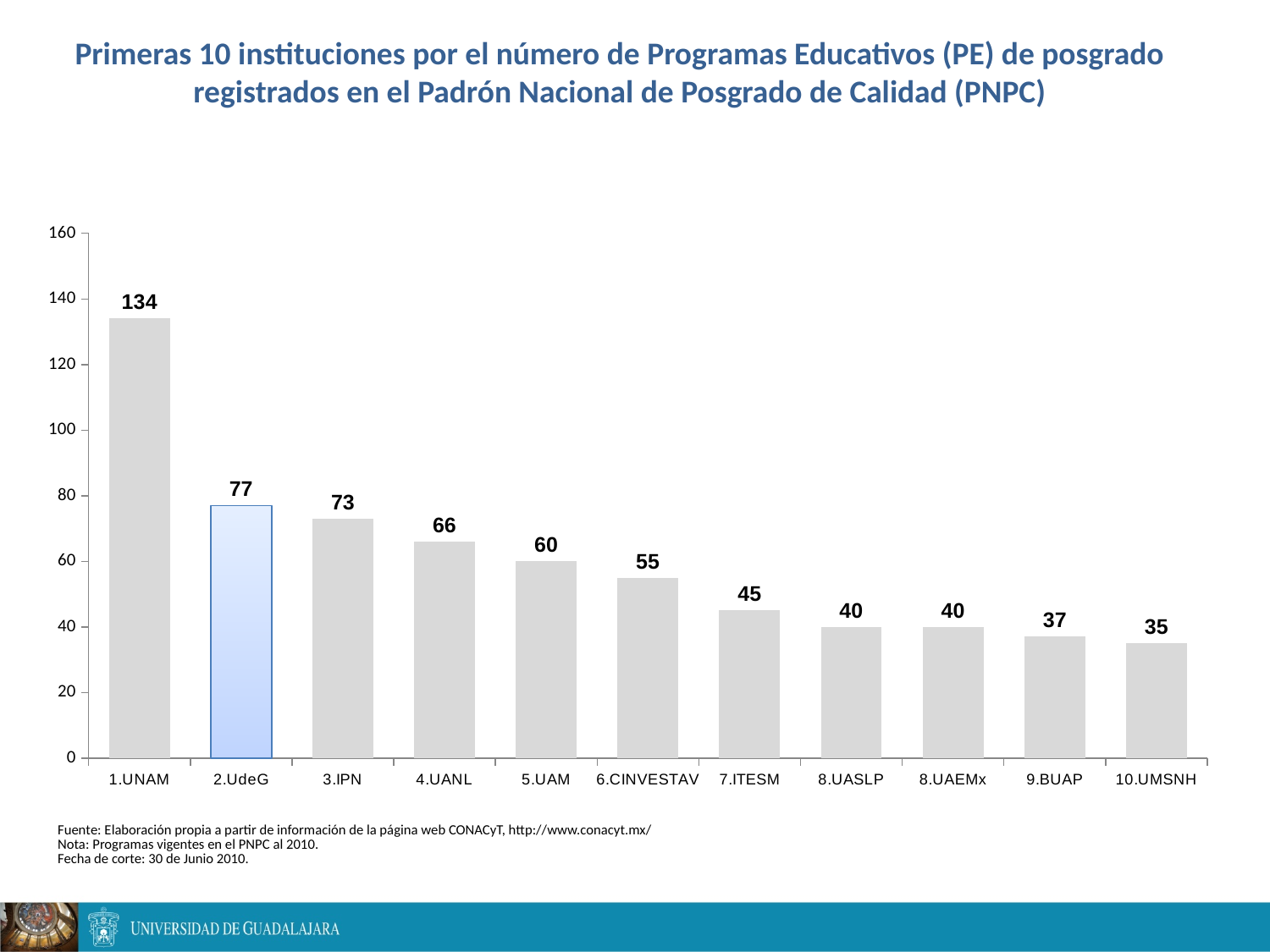
Which institution has the lowest value? 10.UMSNH What is the value for 6.CINVESTAV? 55 What kind of chart is shown on the slide? bar chart Do the values rise or fall from left to right along the x axis? fall How many institutions are shown on the chart? 11 What is the value for 10.UMSNH? 35 What is the difference between the values for 3.IPN and 4.UANL? 7 What is the difference between the values for 1.UNAM and 2.UdeG? 57 Which institution has the highest value? 1.UNAM What is the value for 2.UdeG? 77 Which is larger, the value for 5.UAM or the value for 7.ITESM? 5.UAM Is the value for 1.UNAM greater or less than 120? greater